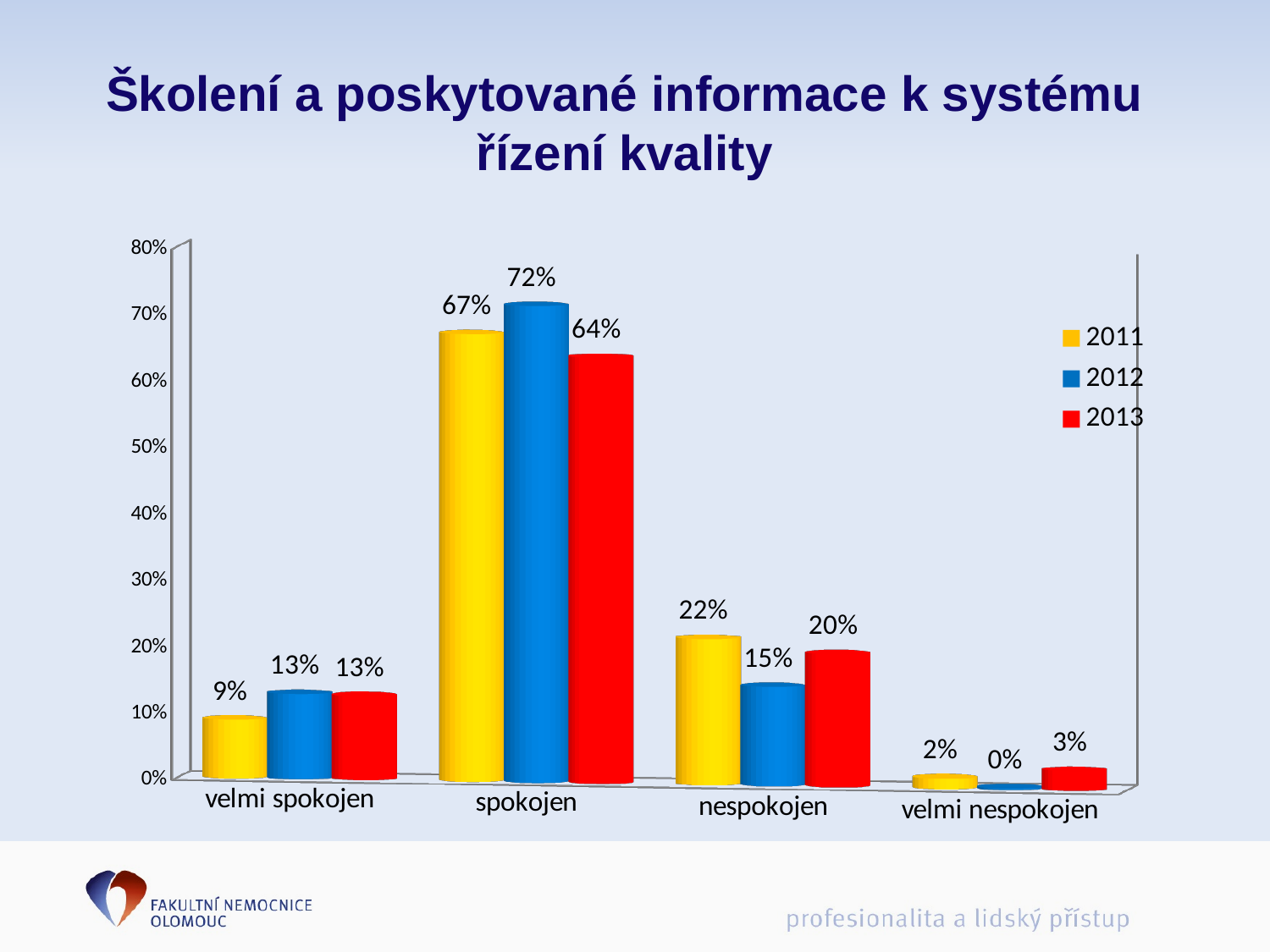
Which is larger in the 'nespokojen' category: the 2011 value or the 2012 value? 2011 Which category has the highest value for 2013? spokojen How many categories are shown on the x axis? 4 What is the value for 2012 in the 'velmi nespokojen' category? 0% What is the value for 2011 in the 'velmi spokojen' category? 9% Which colour represents the 2013 series in the legend? red Which category has the lowest value for 2011? velmi nespokojen What kind of chart is shown on the slide? bar chart What is the value for 2013 in the 'nespokojen' category? 20% What is the value for 2012 in the 'spokojen' category? 72% What is the difference between the 2012 and 2013 values in the 'spokojen' category? 8% How many series does the legend list? 3